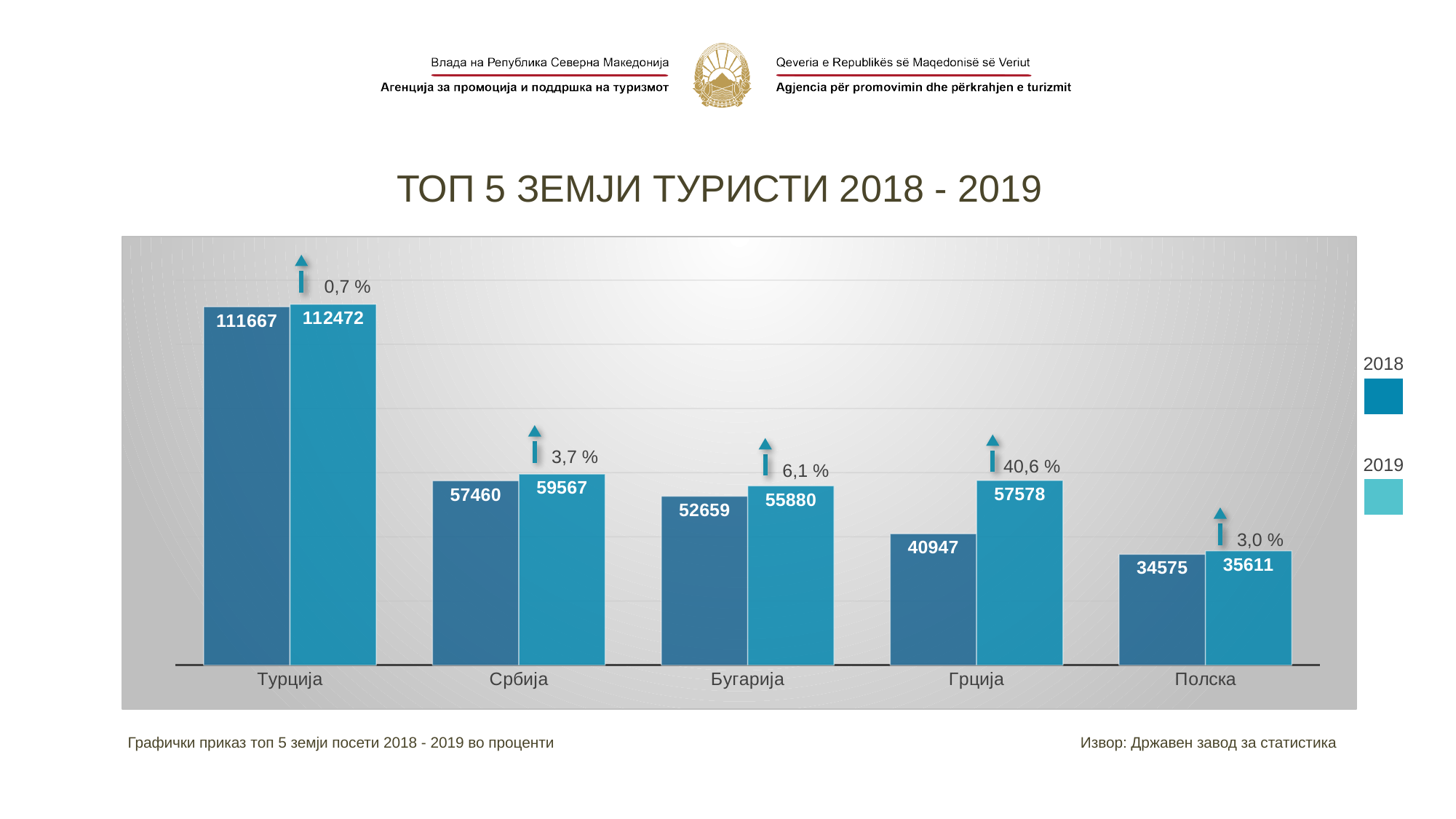
What is the value for Полска in 2018? 34575 Which country has the highest value in 2019? Турција What is the value for Турција in 2018? 111667 What is the value for Грција in 2019? 57578 Which is larger: the 2019 value for Србија or the 2019 value for Грција? Србија What is the difference between the 2019 and 2018 values for Грција? 16631 What is the difference between the 2019 and 2018 values for Турција? 805 Which country has the lowest value in 2018? Полска What kind of chart is shown on the slide? bar chart How many series does the legend list? 2 What percentage change is shown above the bars for Грција? 40,6 % How many countries are shown on the x axis? 5